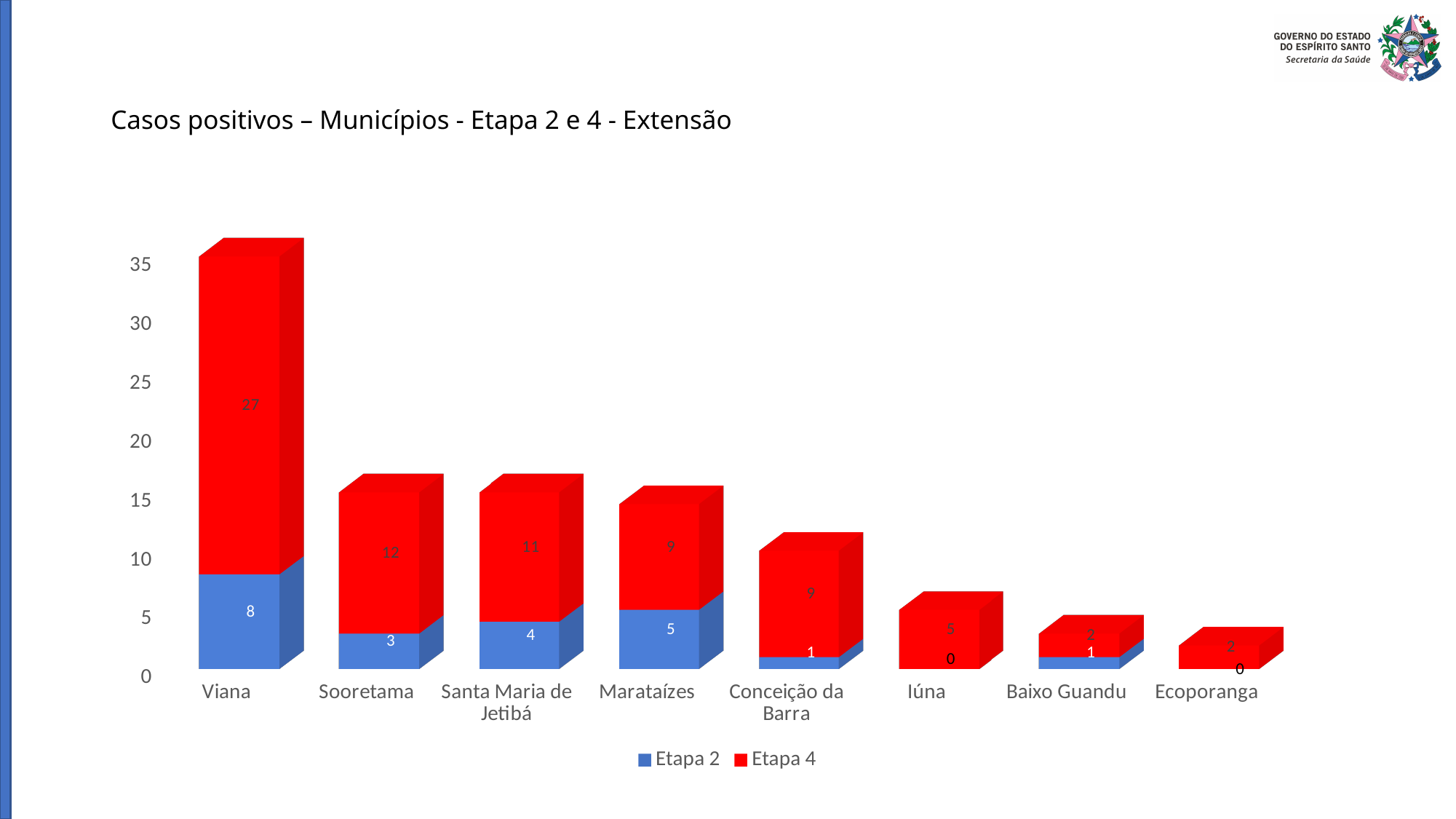
How many series does the legend list? 2 How many municipalities are shown on the x axis? 8 What is the total of the stacked bar for Viana? 35 What is the total of the stacked bar for Santa Maria de Jetibá? 15 What is the Etapa 2 value for Marataízes? 5 Which municipality has the lowest Etapa 2 value among Viana, Sooretama, Santa Maria de Jetibá and Marataízes? Sooretama What is the Etapa 4 value for Viana? 27 Which municipality has the highest Etapa 4 value? Viana What is the Etapa 4 value for Sooretama? 12 What is the Etapa 2 value for Iúna? 0 Which is larger, the Etapa 2 value for Santa Maria de Jetibá or the Etapa 2 value for Marataízes? Marataízes What is the difference between the Etapa 4 values for Viana and Sooretama? 15